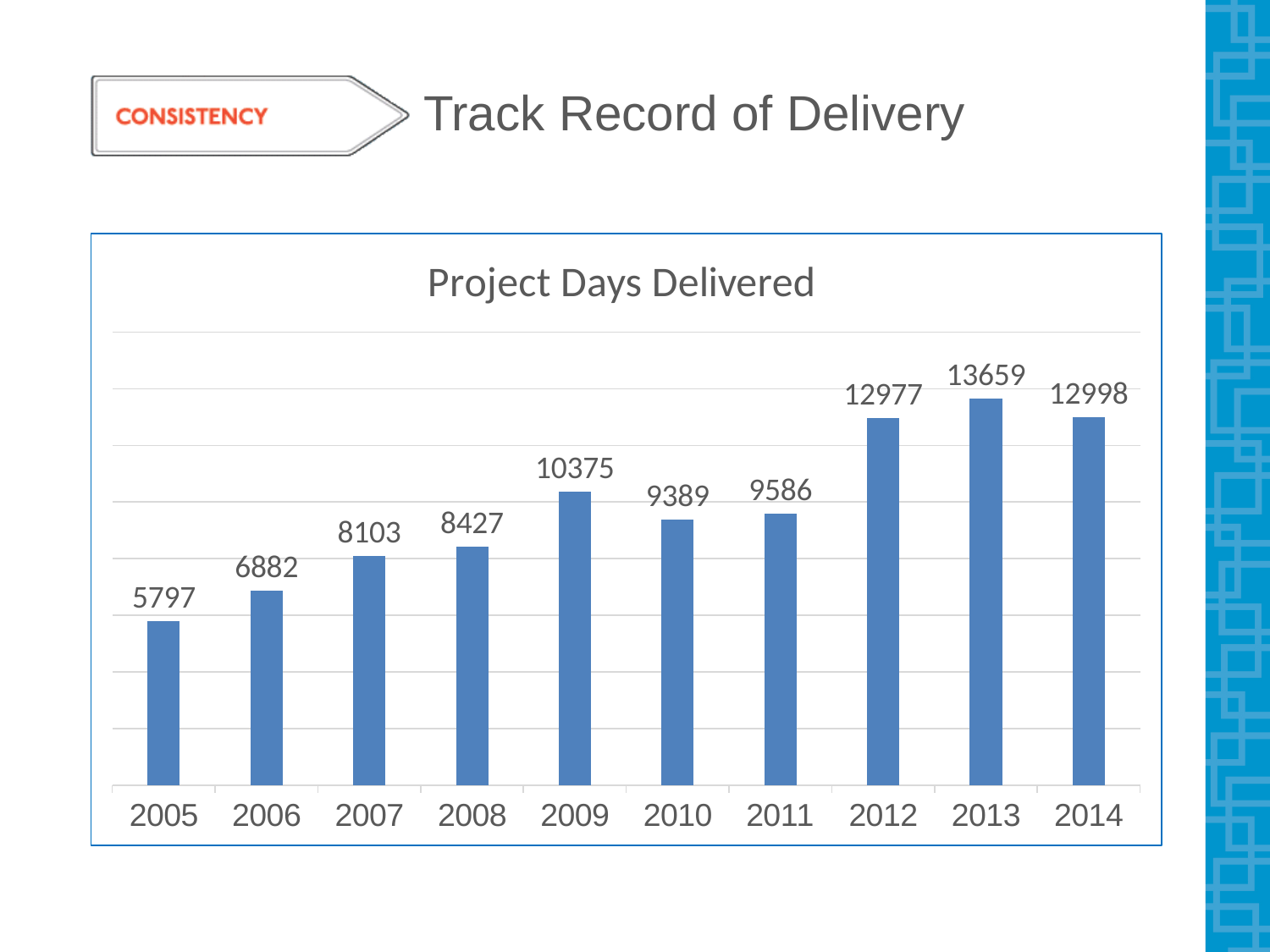
What is the value for 2012 in the Project Days Delivered chart? 12977 What is the difference between the values for 2009 and 2010 in the Project Days Delivered chart? 986 Which is larger in the Project Days Delivered chart, the value for 2009 or the value for 2011? 2009 Which year has the lowest value in the Project Days Delivered chart? 2005 Which is larger in the Project Days Delivered chart, the value for 2007 or the value for 2008? 2008 What is the difference between the values for 2013 and 2012 in the Project Days Delivered chart? 682 What is the title of the chart on the slide? Project Days Delivered What kind of chart is the Project Days Delivered chart? bar chart How many years are shown on the x axis of the Project Days Delivered chart? 10 Which year has the highest value in the Project Days Delivered chart? 2013 What is the value for 2005 in the Project Days Delivered chart? 5797 What is the value for 2009 in the Project Days Delivered chart? 10375